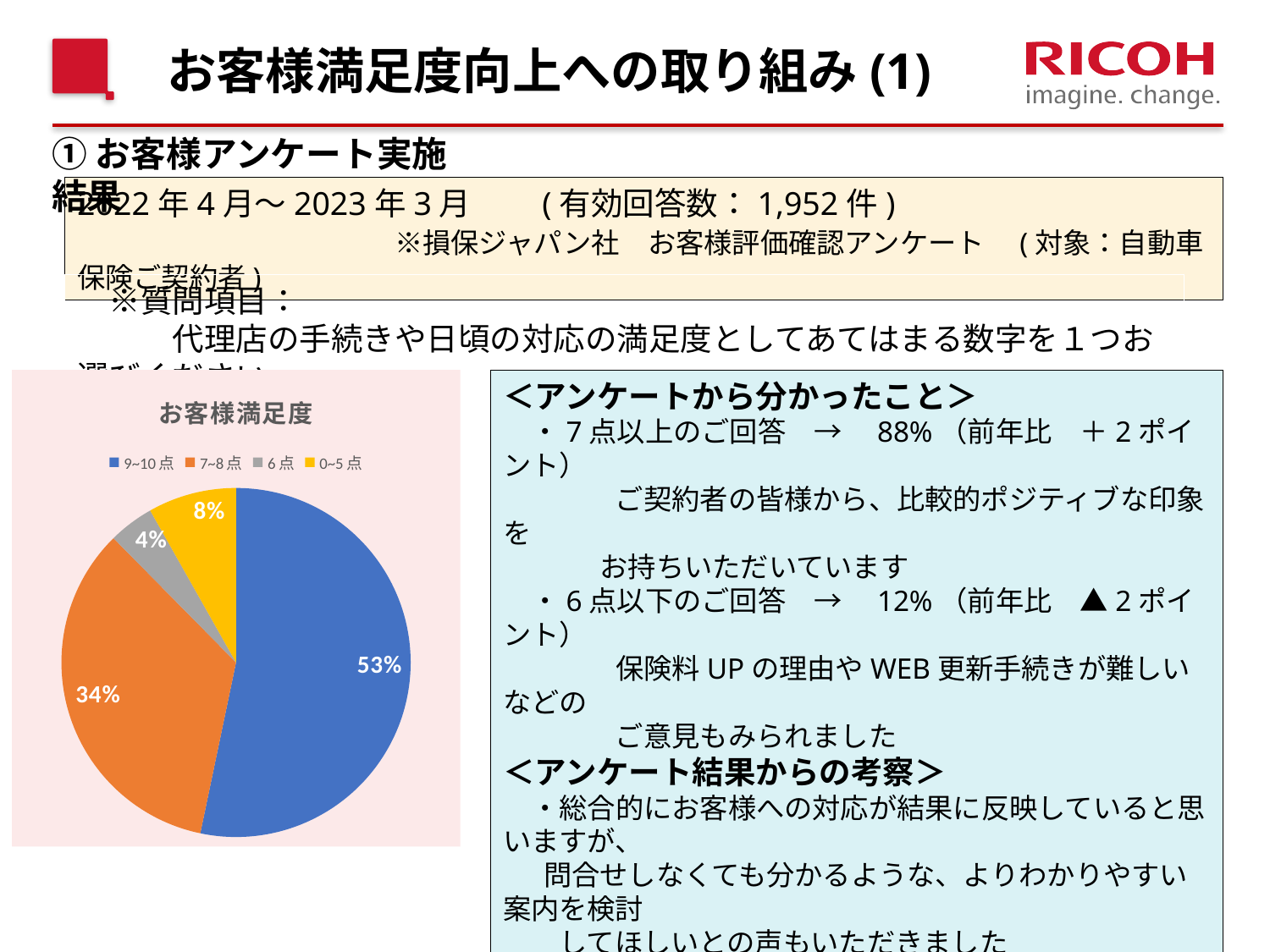
Which category has the largest slice in the pie chart? 9~10点 What is the value shown for the 7~8点 slice? 34% What share of the pie does the 9~10点 slice represent? 53% What is the difference between the 9~10点 slice and the 7~8点 slice? 19% Which is larger, the 0~5点 slice or the 6点 slice? 0~5点 What kind of chart is shown on the slide? pie chart What is the value shown for the 0~5点 slice? 8% What is the title of the pie chart? お客様満足度 Which category has the smallest slice in the pie chart? 6点 What is the value shown for the 6点 slice? 4% How many slices does the pie chart have? 4 How many entries does the legend of the pie chart list? 4